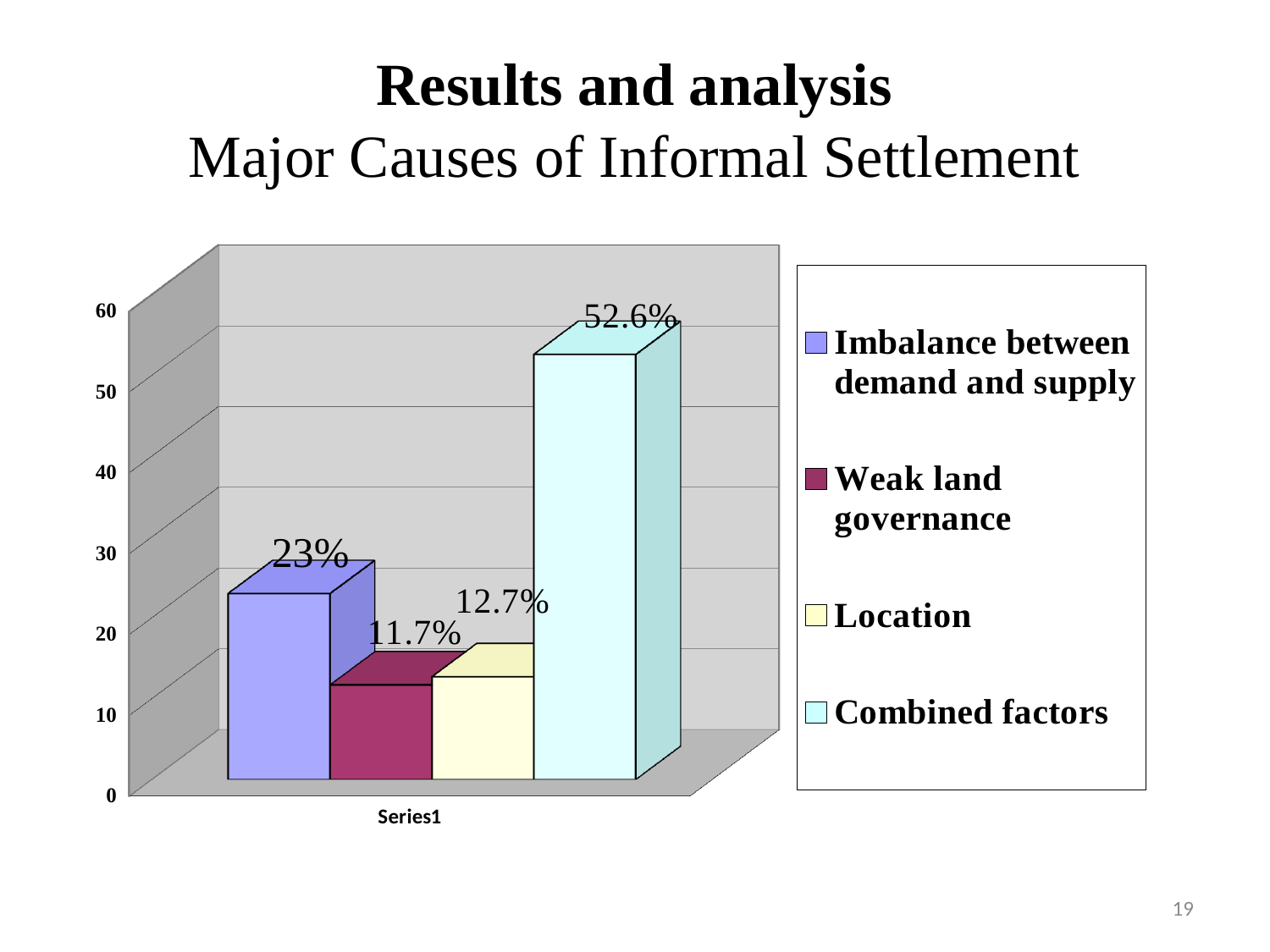
What is the value for Weak land governance? 11.7% How many categories are shown in the legend? 4 What is the value for Imbalance between demand and supply? 23% Which category has the lowest value? Weak land governance Which category has the highest value? Combined factors What is the difference between the values for Combined factors and Imbalance between demand and supply? 29.6% What kind of chart is shown on the slide? bar chart Which is larger, the value for Location or the value for Weak land governance? Location What colour is the bar for Weak land governance? dark red What is the value for Combined factors? 52.6% What is the value for Location? 12.7% Is the value for Combined factors greater or less than 50? greater